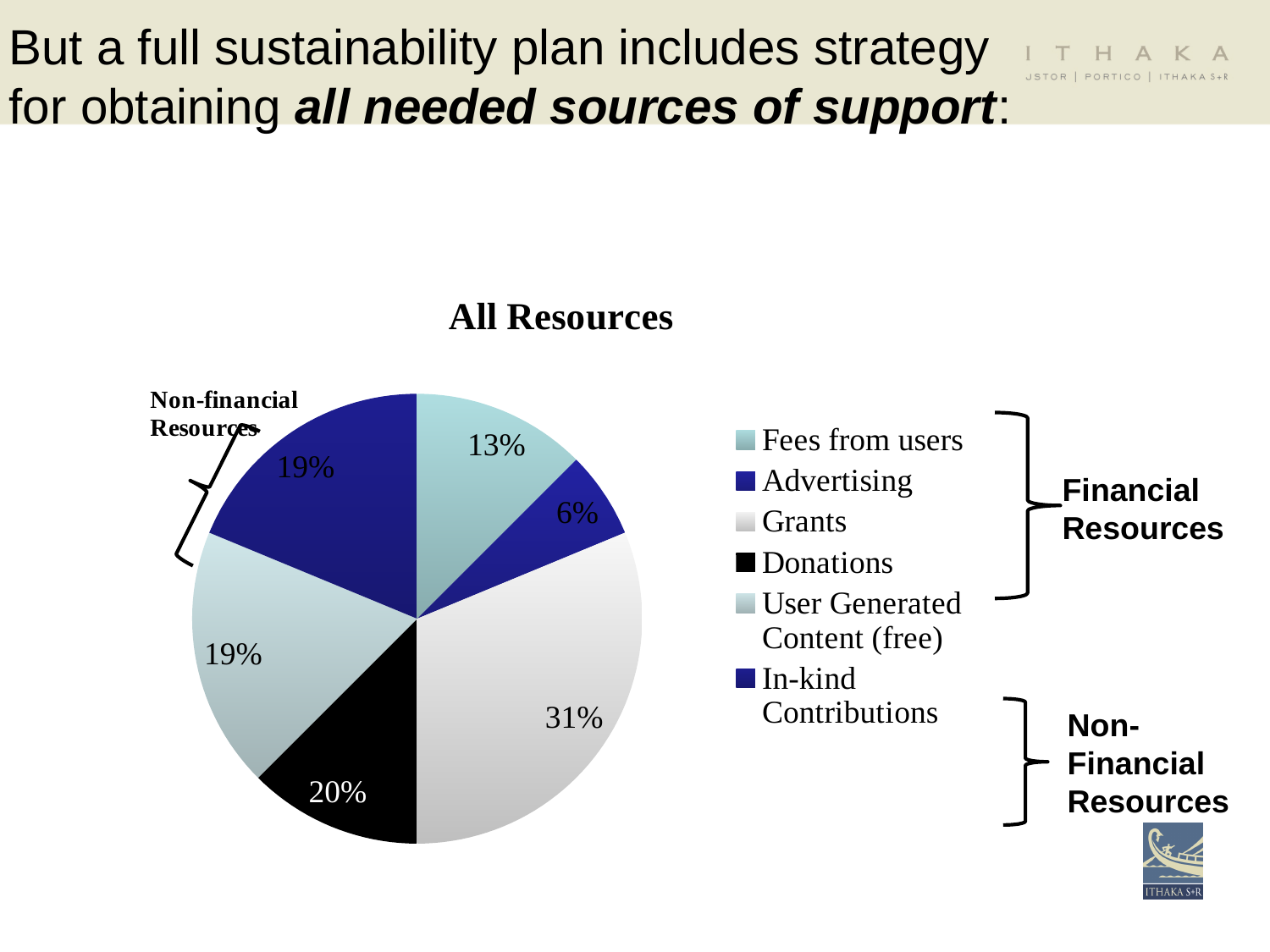
What kind of chart is shown on the slide? pie chart What share of the pie is Fees from users? 13% What share of the pie is Grants? 31% What share of the pie is In-kind Contributions? 19% Which category has the largest slice of the pie? Grants What is the title of the chart? All Resources How many categories does the legend list? 6 Which category has the smallest slice of the pie? Advertising What share of the pie is Donations? 20% What share of the pie is Advertising? 6% What is the difference in percentage points between Grants and Donations? 11